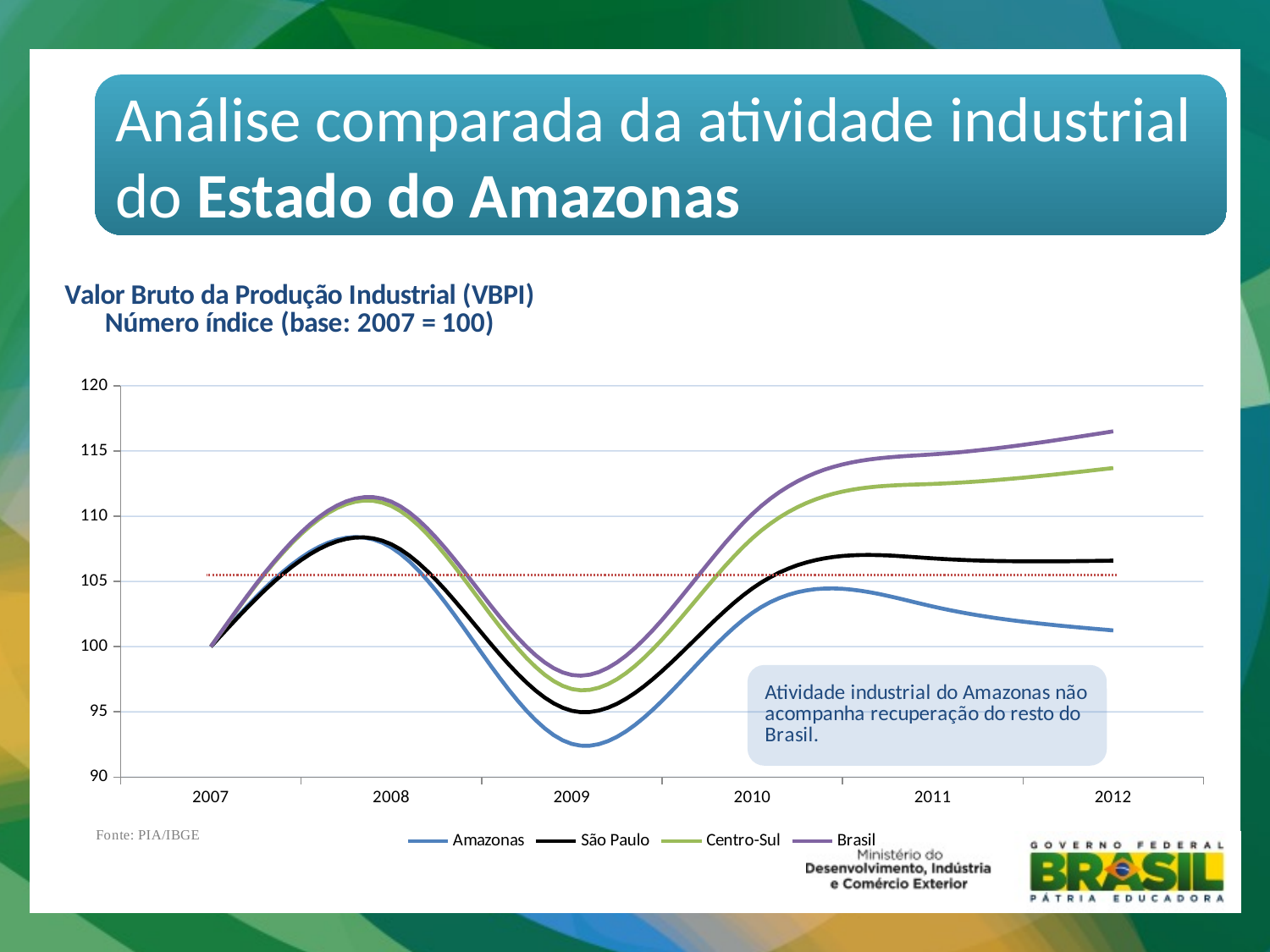
How many years are labelled on the x axis of the chart? 6 What is the index value for Amazonas in 2007? 100 Is the value for Amazonas in 2009 greater or less than 95? less Which series has the lowest value in 2012? Amazonas What kind of chart is shown on the slide? line chart Is the value for Brasil in 2012 greater or less than 115? greater How many series does the chart legend list? 4 Is the value for Amazonas in 2012 greater or less than 105? less Which series has the highest value in 2012? Brasil Does the Amazonas line rise or fall between 2011 and 2012? fall What is the base year of the index shown in the chart subtitle? 2007 = 100 In 2012, which is larger: the value for Brasil or the value for Amazonas? Brasil